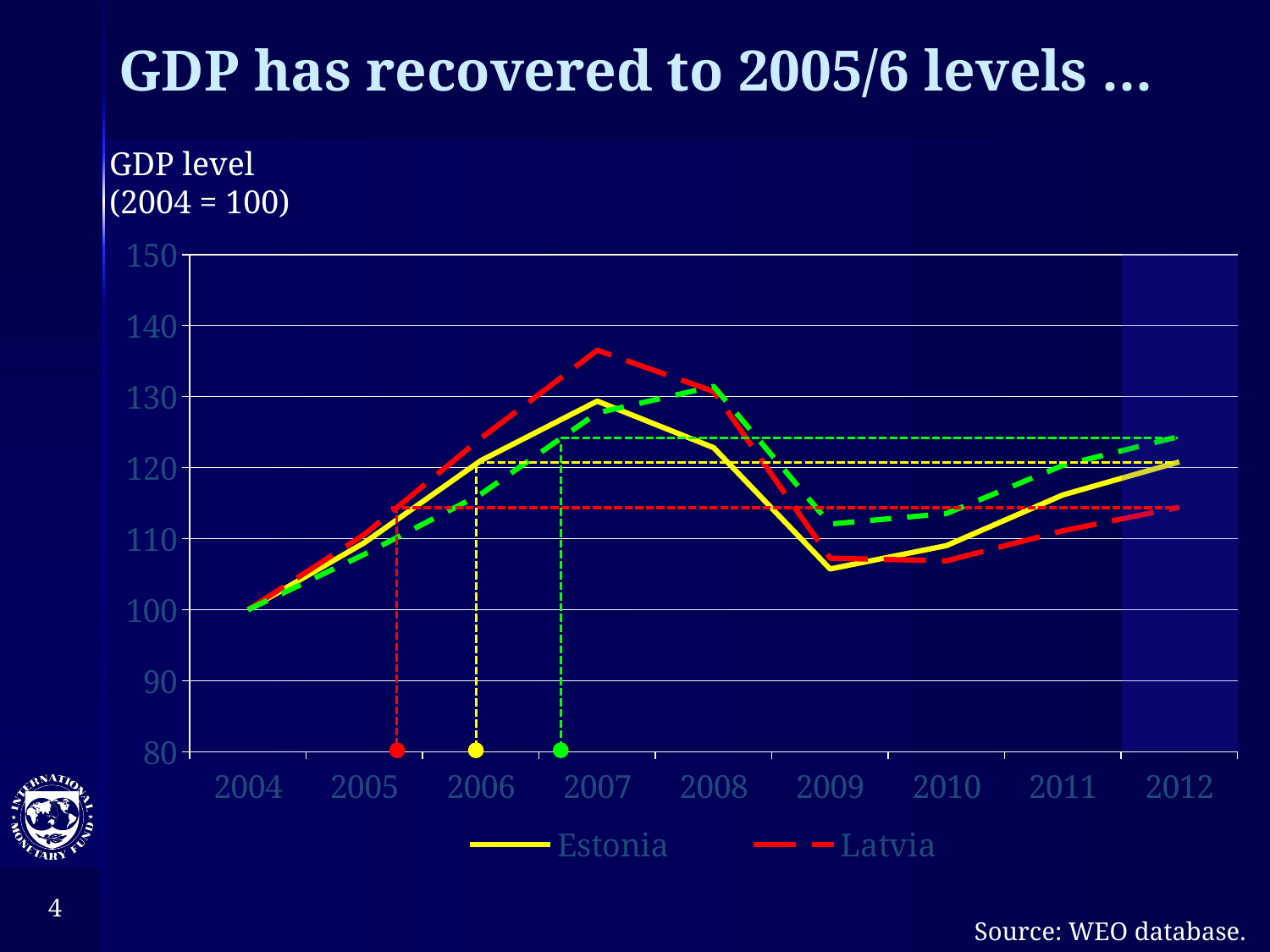
Is the value for Latvia in 2007 greater or less than 130? greater In 2007, which series has the higher GDP level, Estonia or Latvia? Latvia What kind of chart is shown on the slide? line chart In 2011, which series has the higher GDP level, Estonia or Latvia? Estonia What is the GDP level value for Estonia in 2004? 100 What is the source cited for the chart data? WEO database Does the Estonia line rise or fall from 2009 to 2012? rise In which year does the Latvia line reach its highest point? 2007 Is the value for Estonia in 2009 greater or less than 110? less How many years are shown on the x axis of the chart? 9 Is the value for Latvia in 2012 greater or less than 120? less How many series does the chart legend list? 2